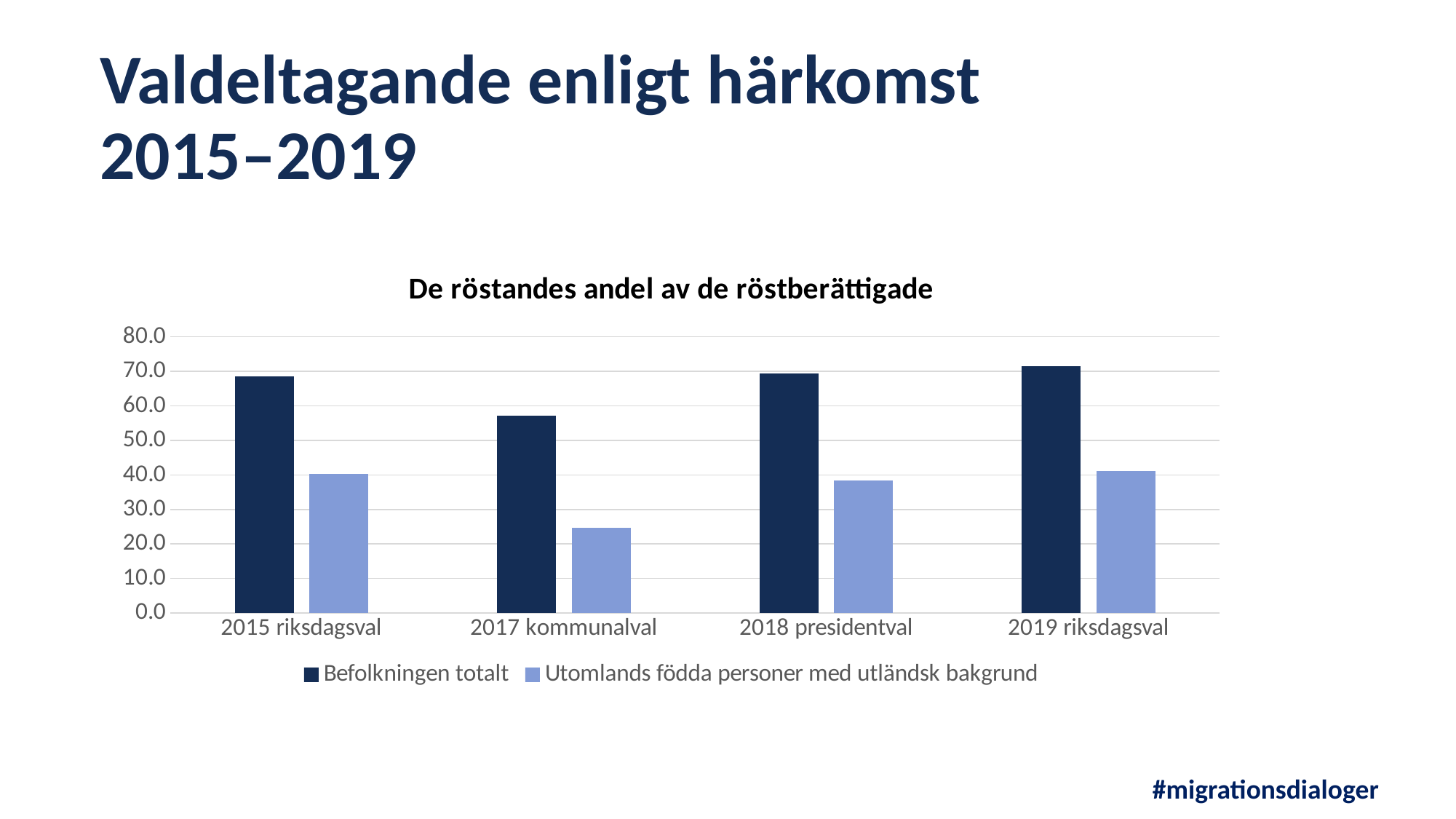
Which is larger for Befolkningen totalt: the value at 2015 riksdagsval or at 2017 kommunalval? 2015 riksdagsval For which election is the value for Befolkningen totalt highest? 2019 riksdagsval What kind of chart is shown on the slide? Bar chart Is the value for Befolkningen totalt at 2017 kommunalval greater or less than 50? greater Which series is shown in dark navy bars? Befolkningen totalt Is the value for Utomlands födda personer med utländsk bakgrund at 2018 presidentval greater or less than 30? greater Is the value for Utomlands födda personer med utländsk bakgrund at 2017 kommunalval greater or less than 30? less For which election is the value for Befolkningen totalt lowest? 2017 kommunalval How many election categories are shown on the x axis? 4 What is the title of the chart? De röstandes andel av de röstberättigade For which election is the value for Utomlands födda personer med utländsk bakgrund lowest? 2017 kommunalval How many series does the legend list? 2